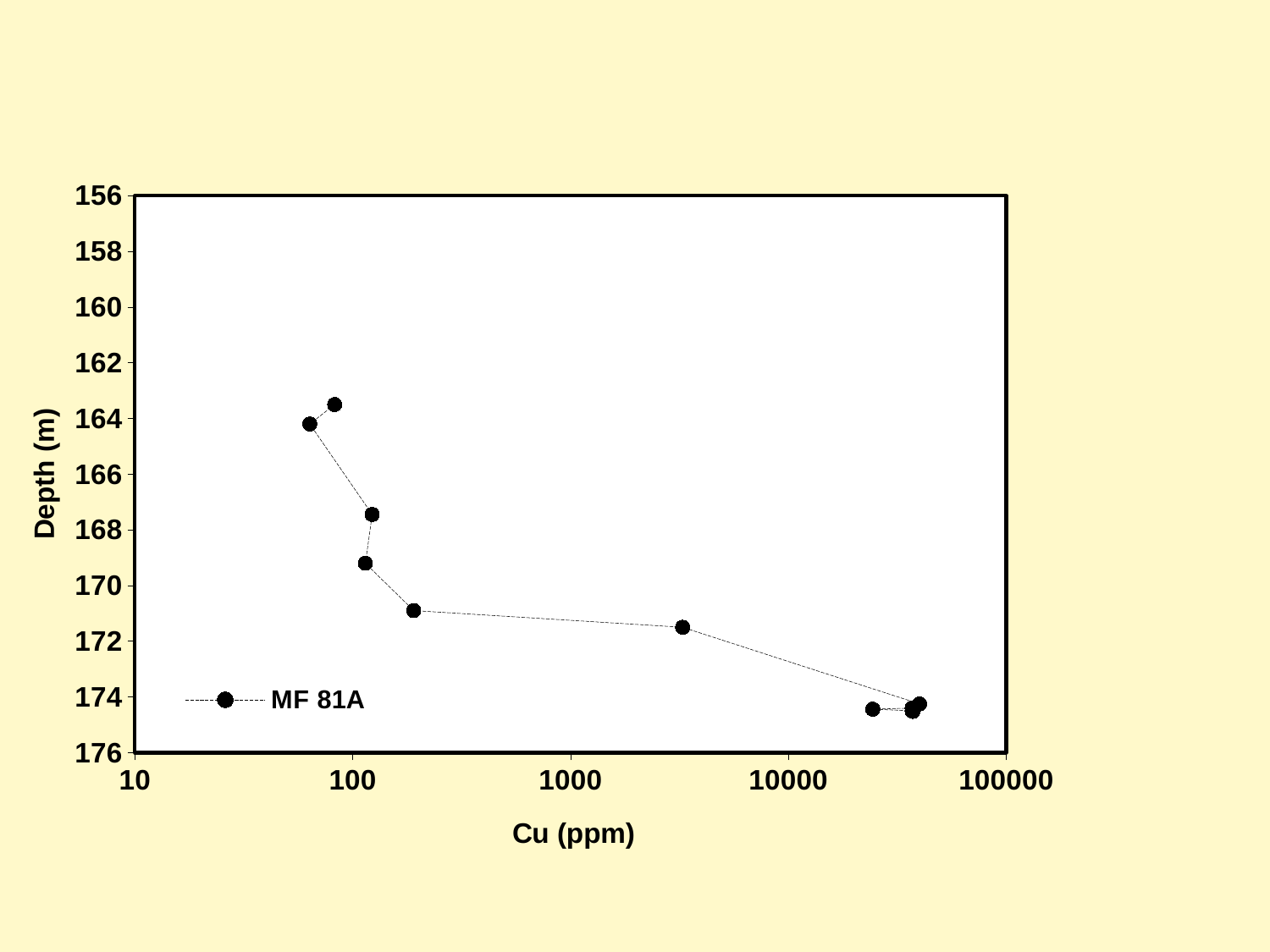
Is the Cu value for the point at about 171.5 m depth greater or less than 1000 ppm? greater Is the Cu value for the point at about 171 m depth greater or less than 100 ppm? greater Is the Cu value for the point at about 164 m depth greater or less than 100 ppm? less What kind of chart is shown on the slide? Scatter (line) chart Does the Cu concentration generally increase or decrease as depth increases from 164 m to 174 m? Increase Which has the higher Cu value: the point at about 171.5 m depth or the point at about 169 m depth? The point at about 171.5 m depth How many series does the legend list? 1 What is the name of the series shown in the legend? MF 81A What is the label of the x axis? Cu (ppm)